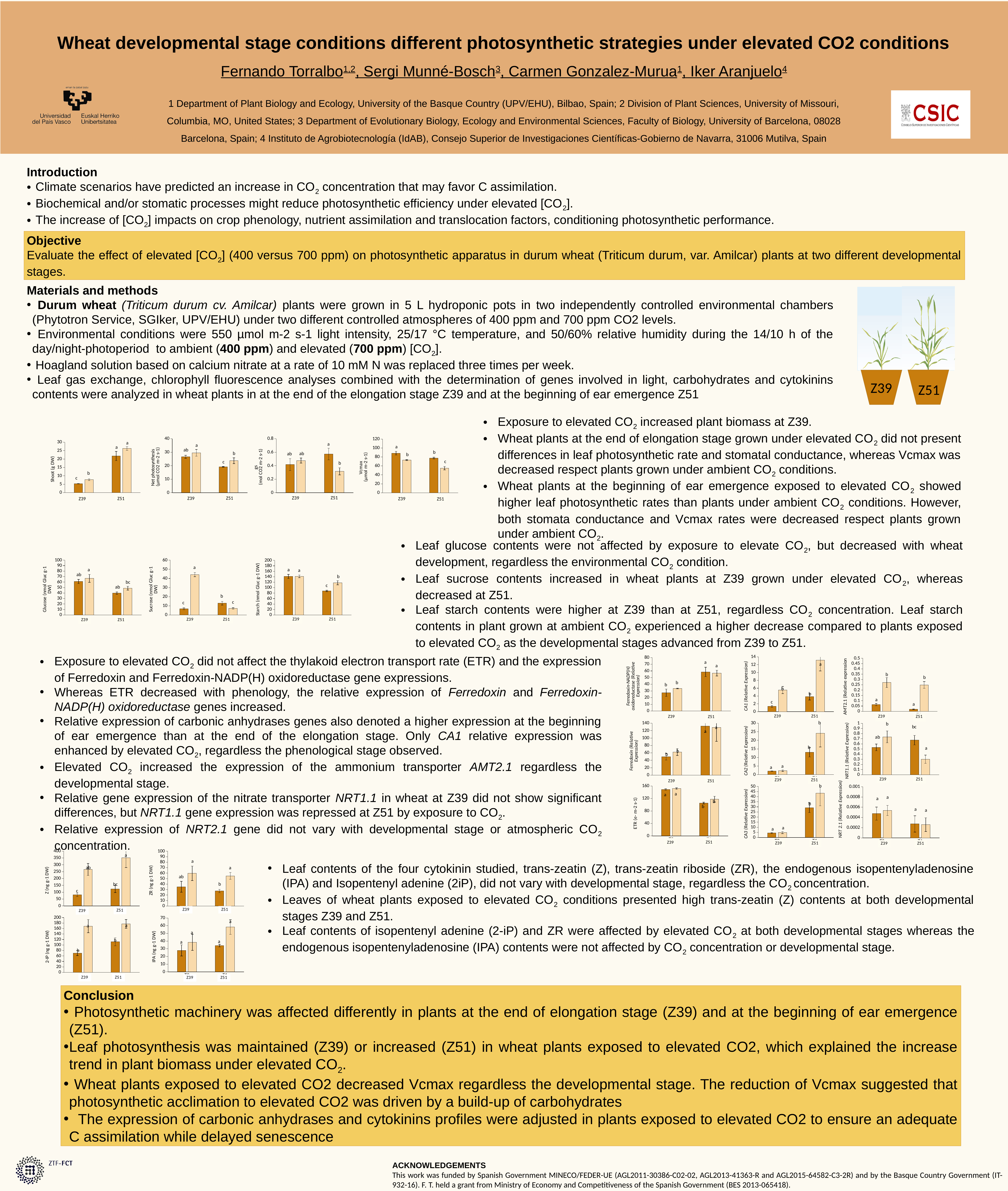
In the Shoot (g DW) chart, is the value of the light bar for Z51 greater or less than 20? greater In the Shoot (g DW) chart, is the value of the dark orange bar for Z39 greater or less than 10? less In the Starch (nmol Gluc g-1 DW) chart, do the values rise or fall from Z39 to Z51? fall In the Sucrose (nmol Gluc g-1 DW) chart, which category has the tallest bar, Z39 or Z51? Z39 In the Vcmax (µmol m-2 s-1) chart, which bar is taller for Z51, the dark orange bar or the light bar? the dark orange bar In the CA1 (Relative Expression) chart, which bar is taller for Z51, the dark orange bar or the light bar? the light bar How many categories are shown on the x axis of the Shoot (g DW) chart? 2 In the Sucrose (nmol Gluc g-1 DW) chart, is the value of the light bar for Z39 greater or less than 40? greater In the Ferredoxin (Relative Expression) chart, do the values rise or fall from Z39 to Z51? rise What kind of chart is the Shoot (g DW) chart? bar chart